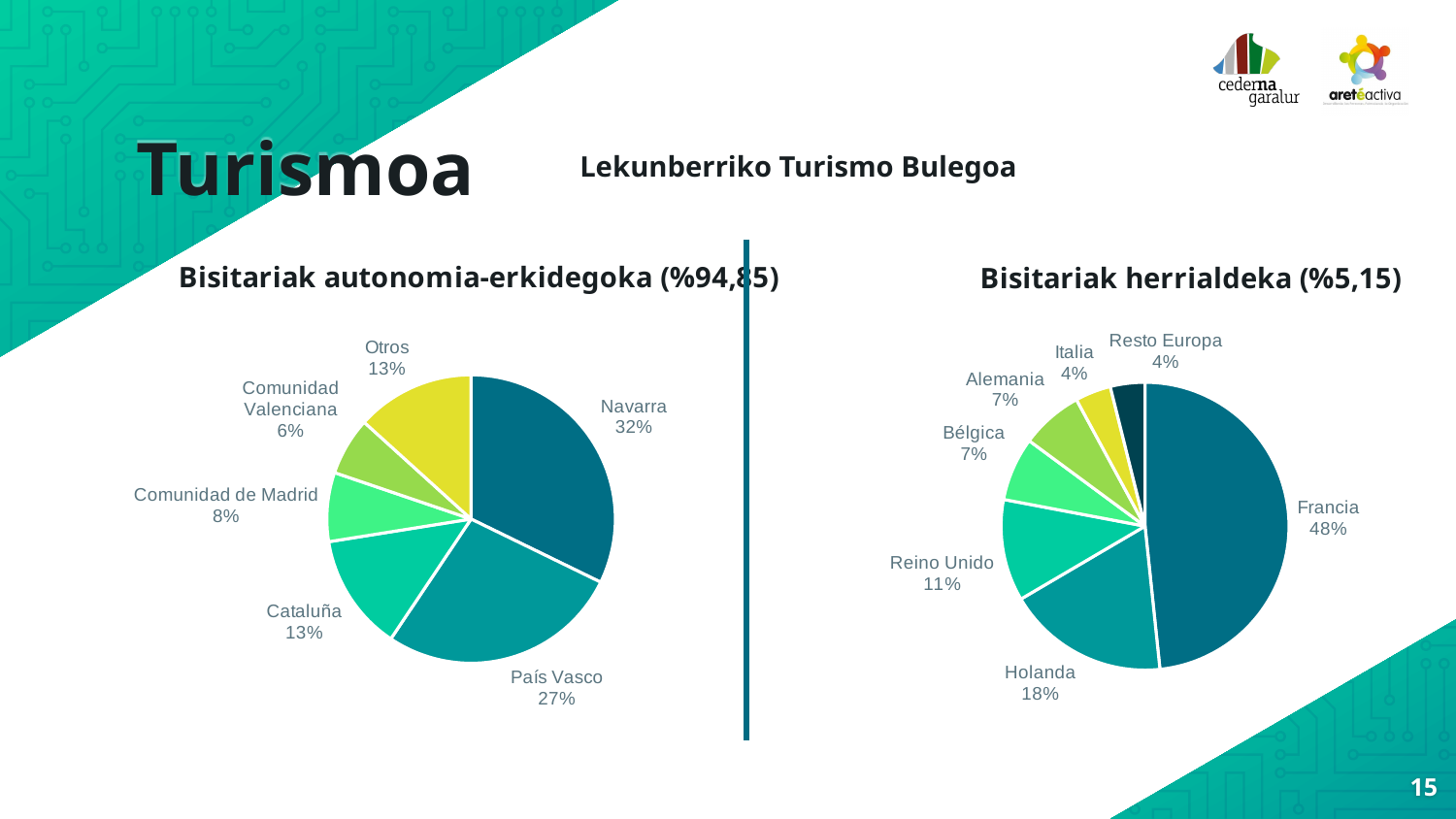
In the left pie chart (Bisitariak autonomia-erkidegoka), what share does País Vasco have? 27% In the left pie chart (Bisitariak autonomia-erkidegoka), which category has the smallest share? Comunidad Valenciana In the left pie chart (Bisitariak autonomia-erkidegoka), which category has the largest share? Navarra How many slices does the right pie chart (Bisitariak herrialdeka) have? 7 In the right pie chart (Bisitariak herrialdeka), what is the difference in percentage points between Francia and Holanda? 30 In the right pie chart (Bisitariak herrialdeka), what share does Francia have? 48% In the right pie chart (Bisitariak herrialdeka), which is larger, Reino Unido or Bélgica? Reino Unido What type of chart is used on the left side of the slide (Bisitariak autonomia-erkidegoka)? Pie chart In the left pie chart (Bisitariak autonomia-erkidegoka), what is the difference in percentage points between Navarra and País Vasco? 5 In the left pie chart (Bisitariak autonomia-erkidegoka), what share does Navarra have? 32% How many slices does the left pie chart (Bisitariak autonomia-erkidegoka) have? 6 In the right pie chart (Bisitariak herrialdeka), what share does Holanda have? 18%